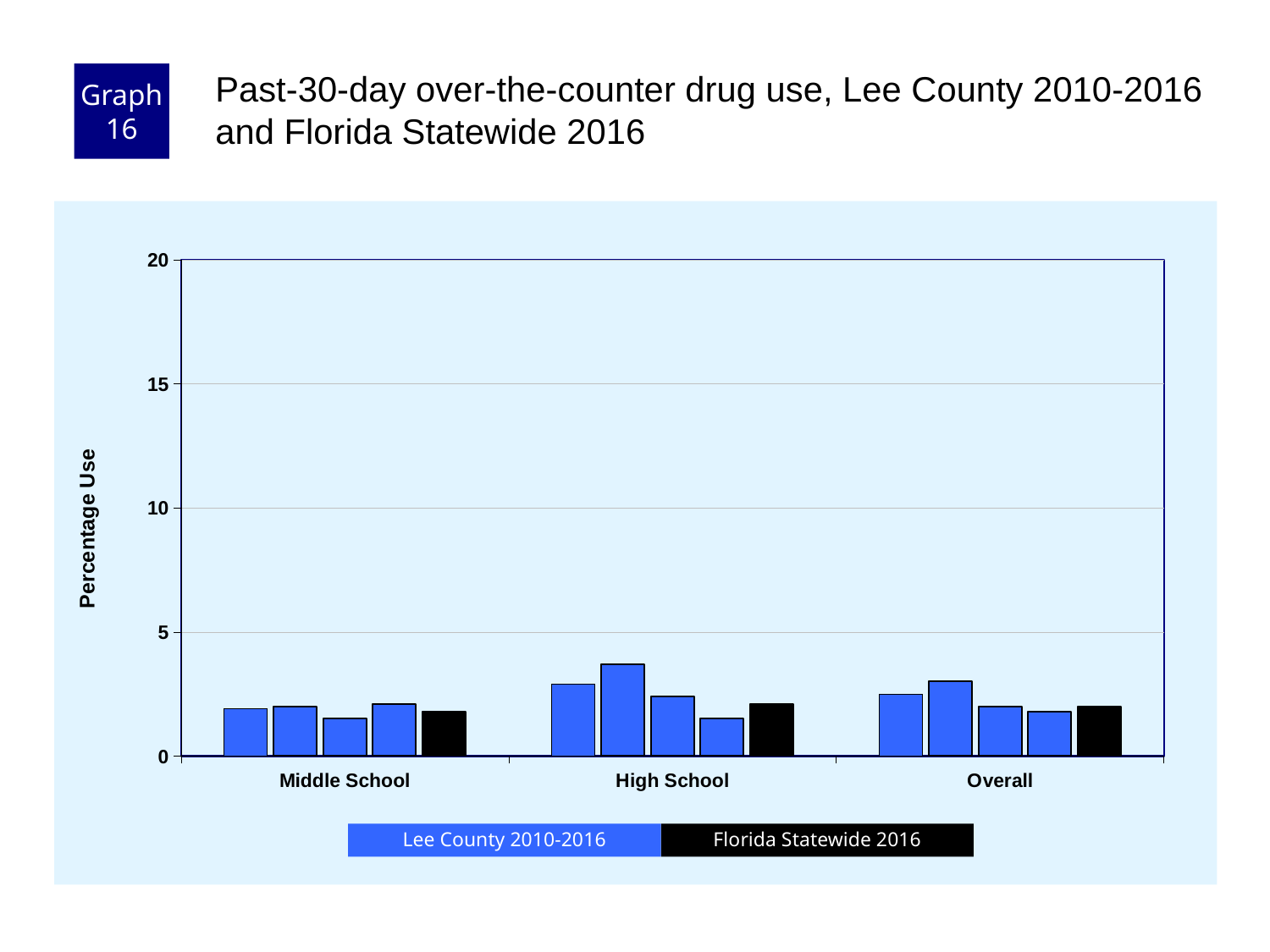
Which is larger: the tallest Lee County bar for High School or the tallest Lee County bar for Middle School? High School Are any of the bars in the chart greater than 10? No Is the Florida Statewide 2016 value for High School greater or less than 5? less What kind of chart is shown on the slide? bar chart What is the maximum value shown on the y axis? 20 What is the label of the y axis? Percentage Use Is the Florida Statewide 2016 value for Middle School greater or less than 5? less Which category group contains the tallest bar in the chart? High School How many categories are shown along the x axis? 3 Which colour represents Florida Statewide 2016 in the legend? black How many series does the legend list? 2